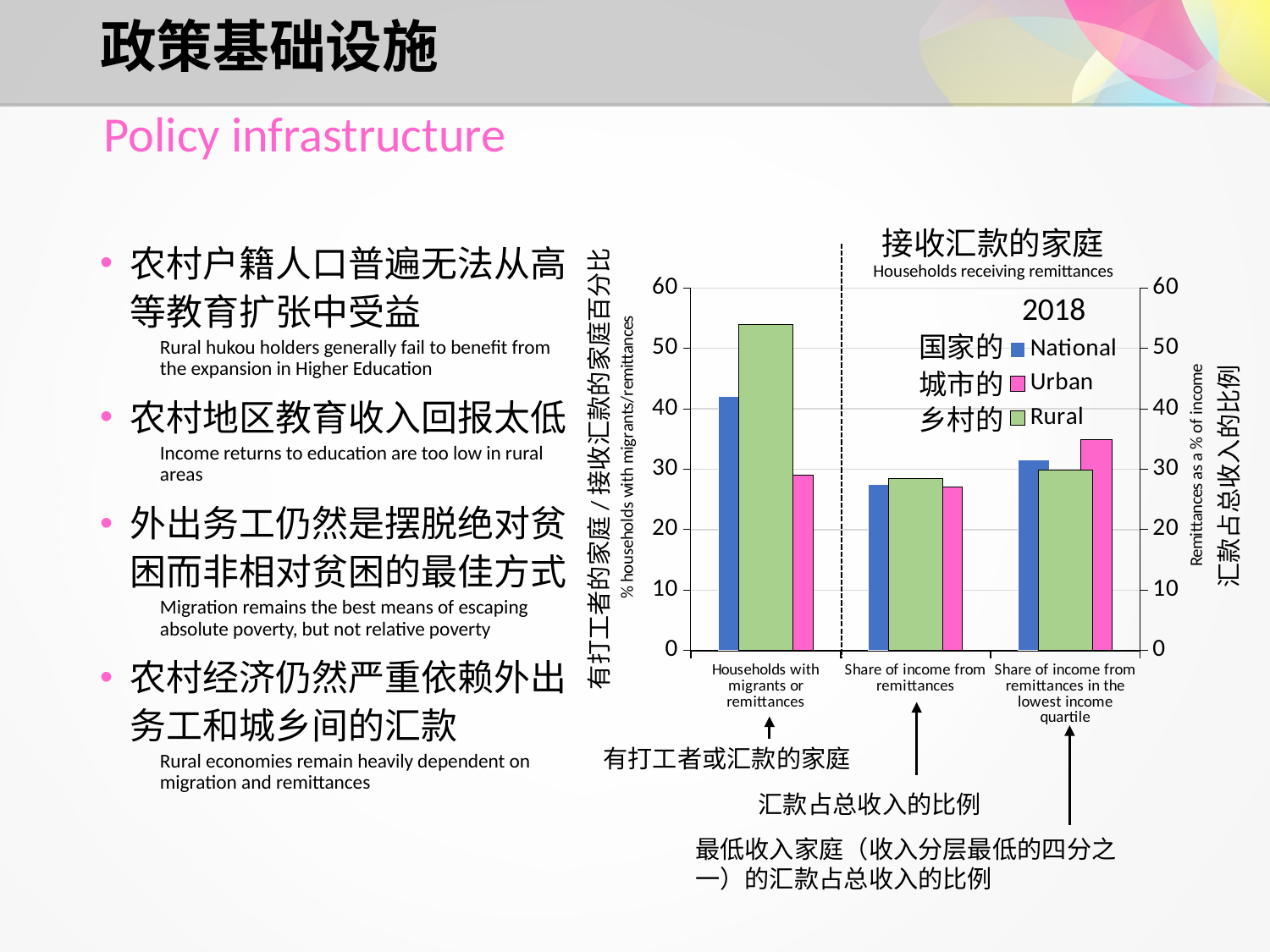
For 'Households with migrants or remittances', which is larger: the National value or the Urban value? National How many categories are shown along the x axis of the chart? 3 Which year is shown in the chart? 2018 Is the Rural value for 'Households with migrants or remittances' greater or less than 50? greater How many series does the chart legend list? 3 Is the Urban value for 'Share of income from remittances in the lowest income quartile' greater or less than 30? greater Which series has the highest value for 'Share of income from remittances in the lowest income quartile'? Urban Which series has the highest value for 'Households with migrants or remittances'? Rural Which series has the lowest value for 'Households with migrants or remittances'? Urban What kind of chart is shown on the slide? bar chart Is the National value for 'Households with migrants or remittances' greater or less than 40? greater